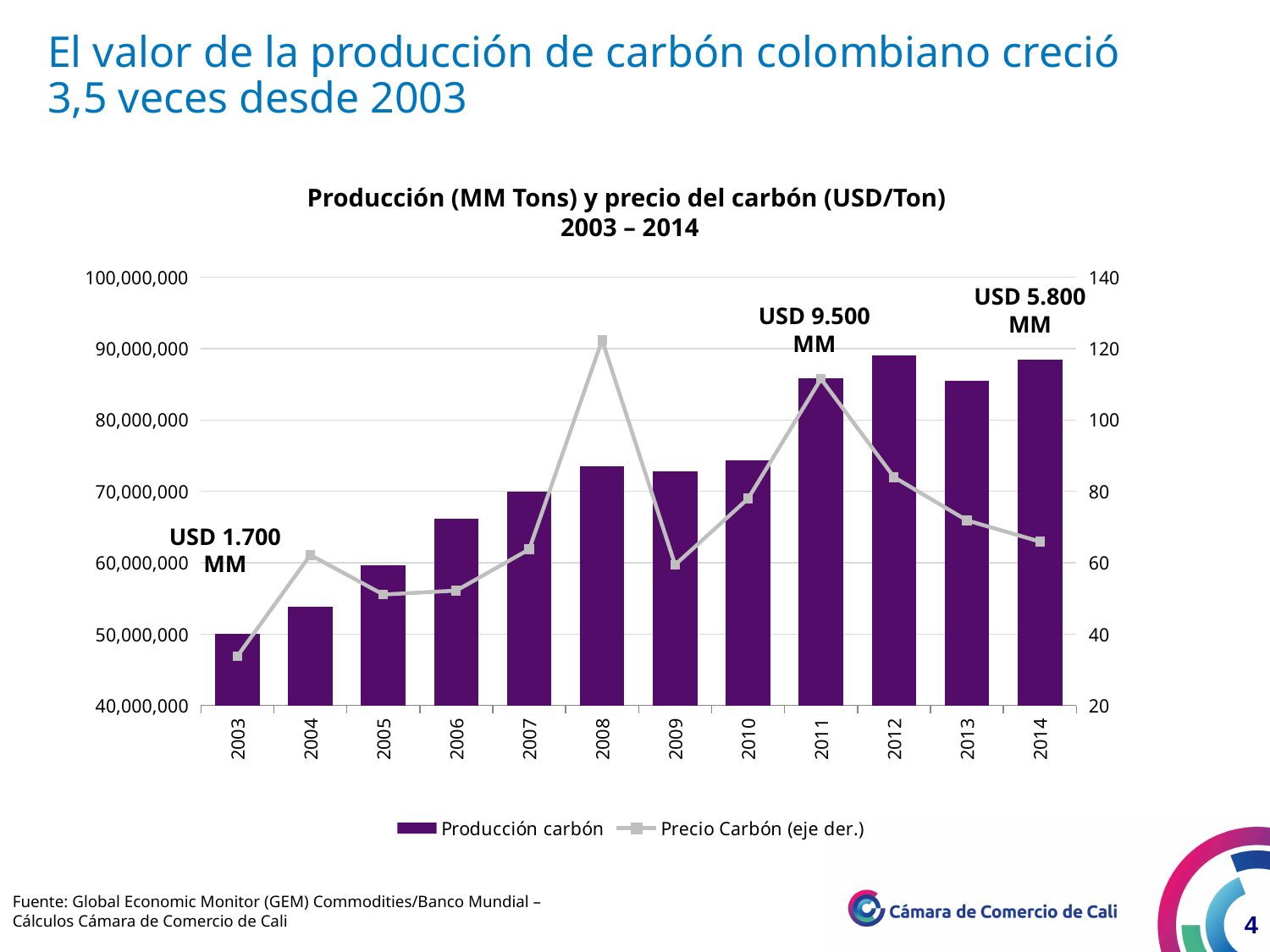
What kind of chart is shown on the slide? A combined bar and line chart Which year has the lowest coal production bar? 2003 How many years are shown on the x axis of the chart? 12 In which year is the coal price line at its lowest point? 2003 Overall, does coal production rise or fall from 2003 to 2014? rise In which year does the coal price line reach its highest point? 2008 Which year has the higher coal price, 2008 or 2009? 2008 Is the coal production value for 2003 greater or less than 60,000,000? less Is the coal price value for 2008 greater or less than 100? greater How many series does the legend list? 2 Is the coal production value for 2012 greater or less than 80,000,000? greater What annotation is shown above the 2011 bar? USD 9.500 MM